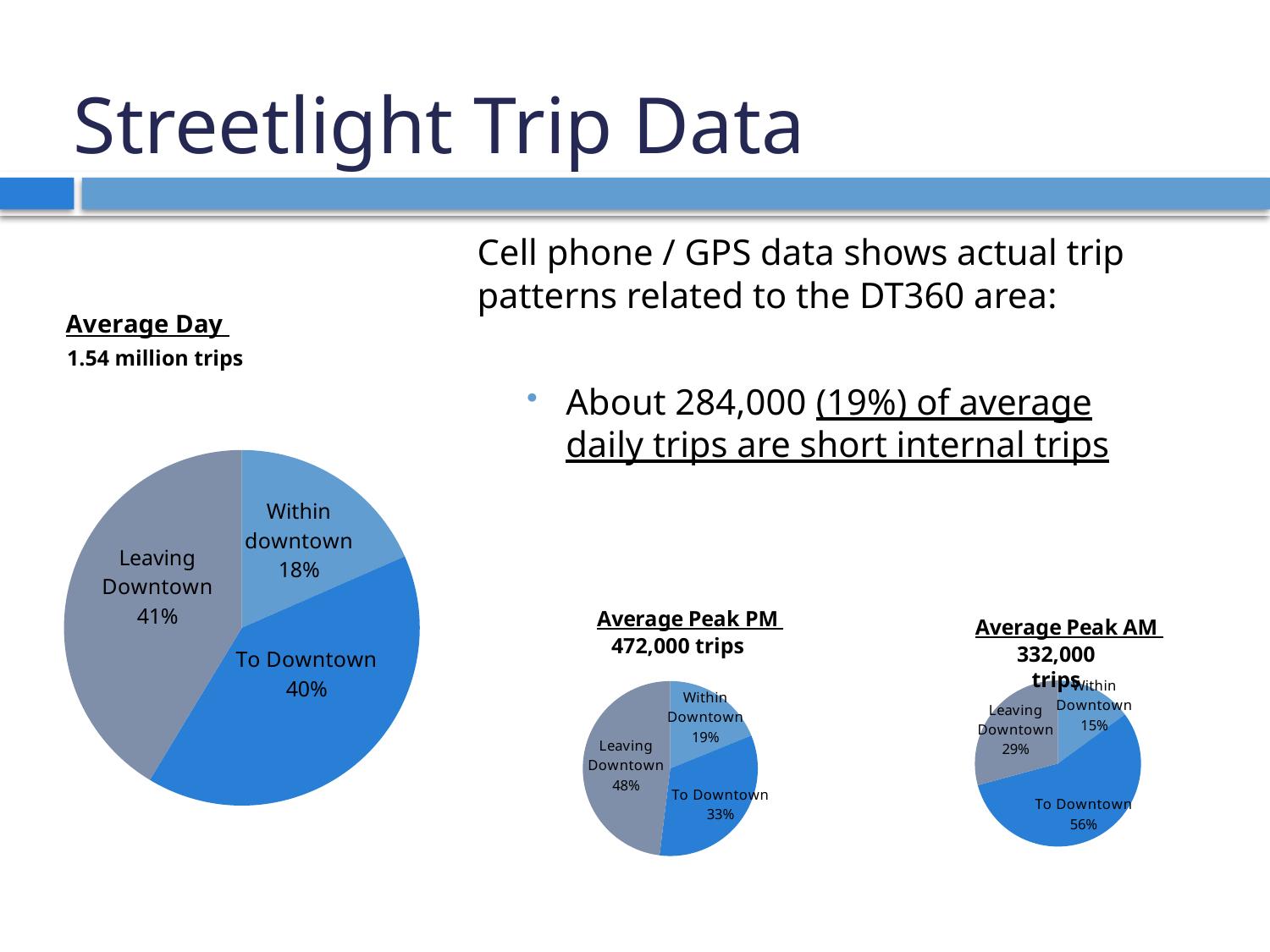
In the Average Peak AM pie chart, which category has the smallest share? Within Downtown In the Average Day pie chart, which category has the smallest share? Within downtown What kind of chart is the Average Day chart? Pie chart In the Average Peak PM pie chart, which is larger, Leaving Downtown or To Downtown? Leaving Downtown In the Average Day pie chart, what share of trips is Leaving Downtown? 41% In the Average Peak AM pie chart, what share of trips is To Downtown? 56% How many trips does the Average Peak AM chart's subtitle state? 332,000 trips In the Average Peak AM pie chart, what is the difference between the To Downtown share and the Leaving Downtown share? 27% In the Average Peak PM pie chart, what share of trips is To Downtown? 33% In the Average Peak PM pie chart, which category has the largest share? Leaving Downtown How many slices does the Average Peak PM pie chart have? 3